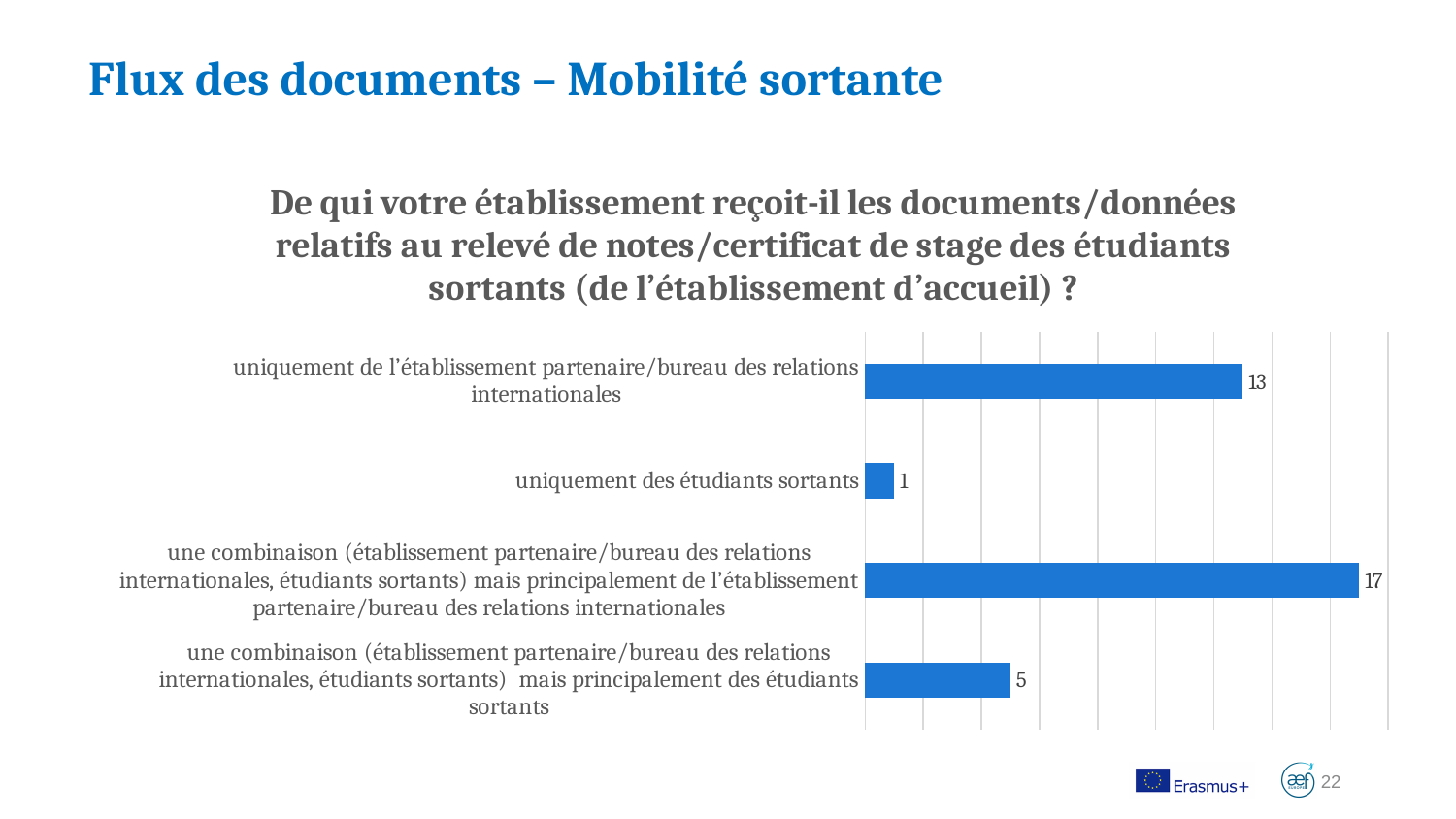
What value is shown for "uniquement des étudiants sortants"? 1 How many categories are shown in the chart? 4 What is the title of the slide? Flux des documents – Mobilité sortante Which category has the lowest value? uniquement des étudiants sortants Which is larger: the value for "uniquement des étudiants sortants" or the value for the combination option mainly from outgoing students? the combination option mainly from outgoing students What value is shown for the combination option that is mainly from outgoing students? 5 What value is shown for "uniquement de l'établissement partenaire/bureau des relations internationales"? 13 What is the difference between the highest value (17) and the value for "uniquement de l'établissement partenaire/bureau des relations internationales" (13)? 4 Which category has the highest value? une combinaison (établissement partenaire/bureau des relations internationales, étudiants sortants) mais principalement de l'établissement partenaire/bureau des relations internationales What kind of chart is shown on the slide? bar chart What is the total of all four values shown in the chart? 36 What value is shown for the combination option that is mainly from the partner institution/international relations office? 17